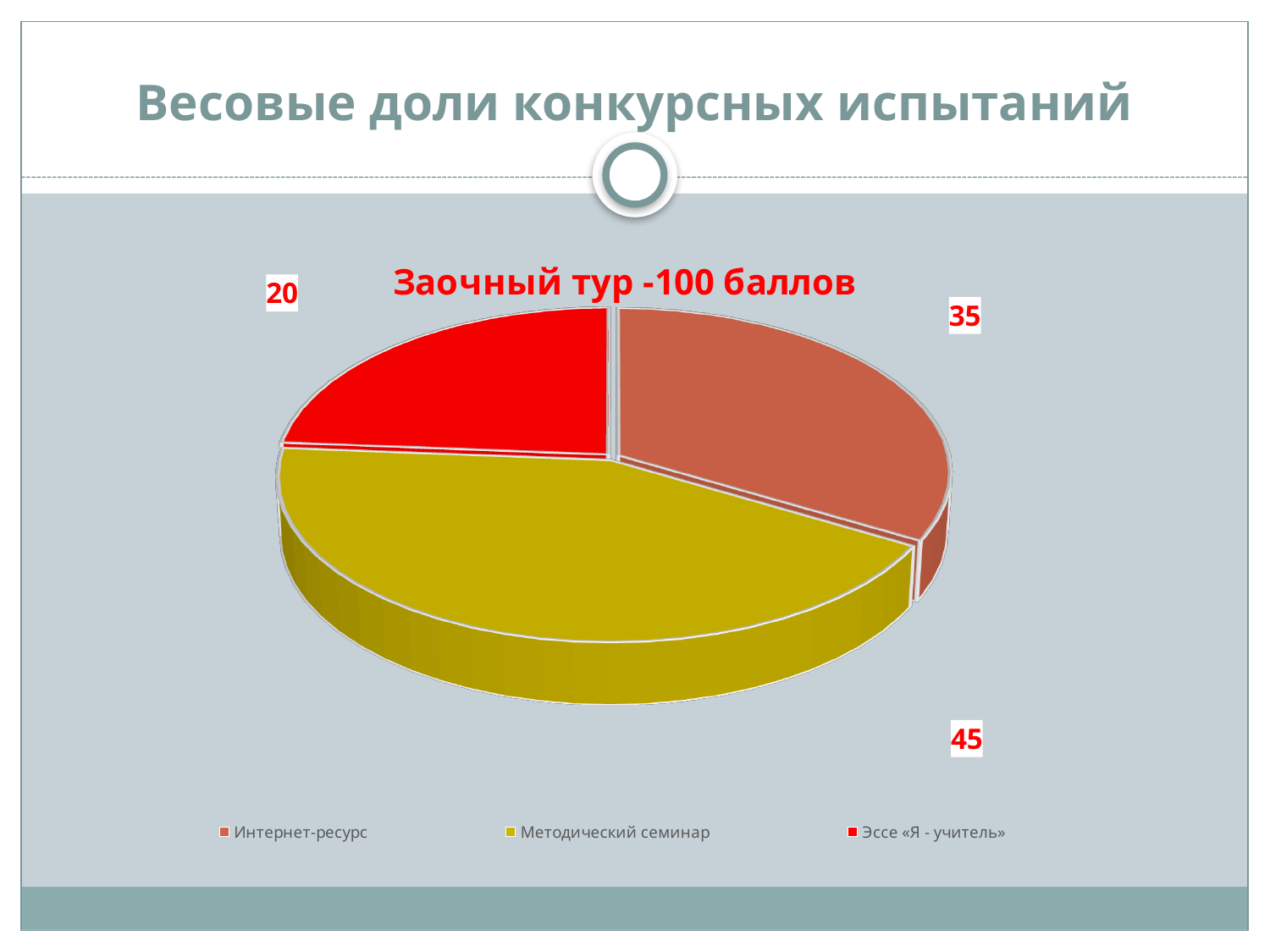
What is the difference between the values for Методический семинар and Интернет-ресурс? 10 Which colour represents Эссе «Я - учитель» in the legend? red What value is shown for Методический семинар? 45 Which is larger, the value for Интернет-ресурс or the value for Эссе «Я - учитель»? Интернет-ресурс Which category has the smallest slice of the pie? Эссе «Я - учитель» What is the chart's title? Заочный тур -100 баллов What value is shown for Интернет-ресурс? 35 What value is shown for Эссе «Я - учитель»? 20 How many slices does the pie chart have? 3 Which category has the largest slice of the pie? Методический семинар What type of chart is shown on the slide? pie chart